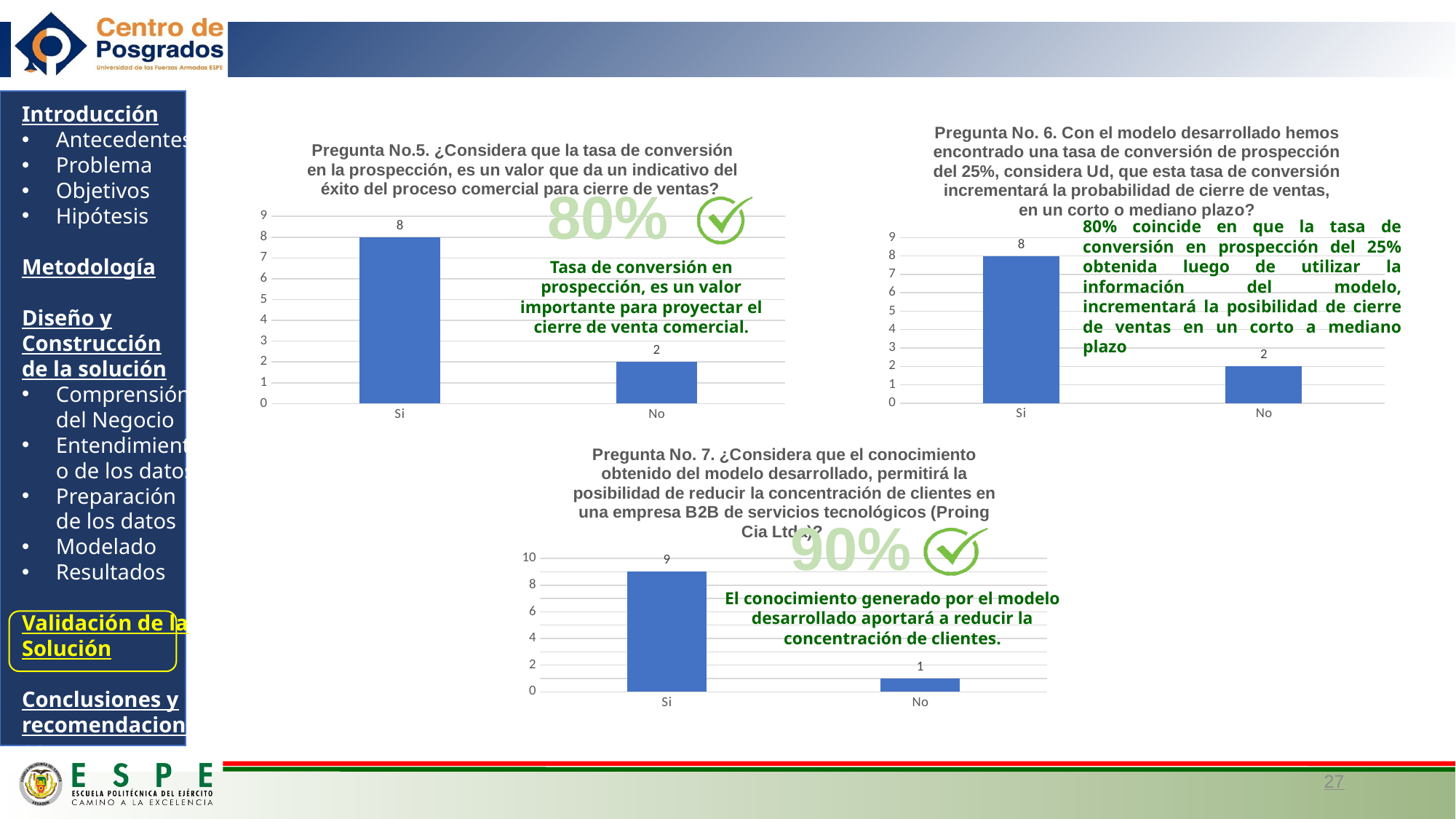
In the Pregunta No.5 chart (top left), what is the value for No? 2 In the Pregunta No.5 chart (top left), what is the value for Si? 8 In the Pregunta No.5 chart (top left), what is the difference between the Si and No values? 6 In the Pregunta No. 6 chart (top right), what is the total of the Si and No values? 10 In the Pregunta No. 6 chart (top right), which category has the lowest value? No In the Pregunta No. 7 chart (bottom), what is the value for Si? 9 In the Pregunta No. 7 chart (bottom), what is the value for No? 1 In the Pregunta No. 7 chart (bottom), which category has the highest value? Si How many categories are shown in the Pregunta No.5 chart (top left)? 2 In the Pregunta No. 7 chart (bottom), what is the difference between the Si and No values? 8 In the Pregunta No. 6 chart (top right), what is the value for Si? 8 What kind of chart is the Pregunta No. 7 chart (bottom)? Bar chart